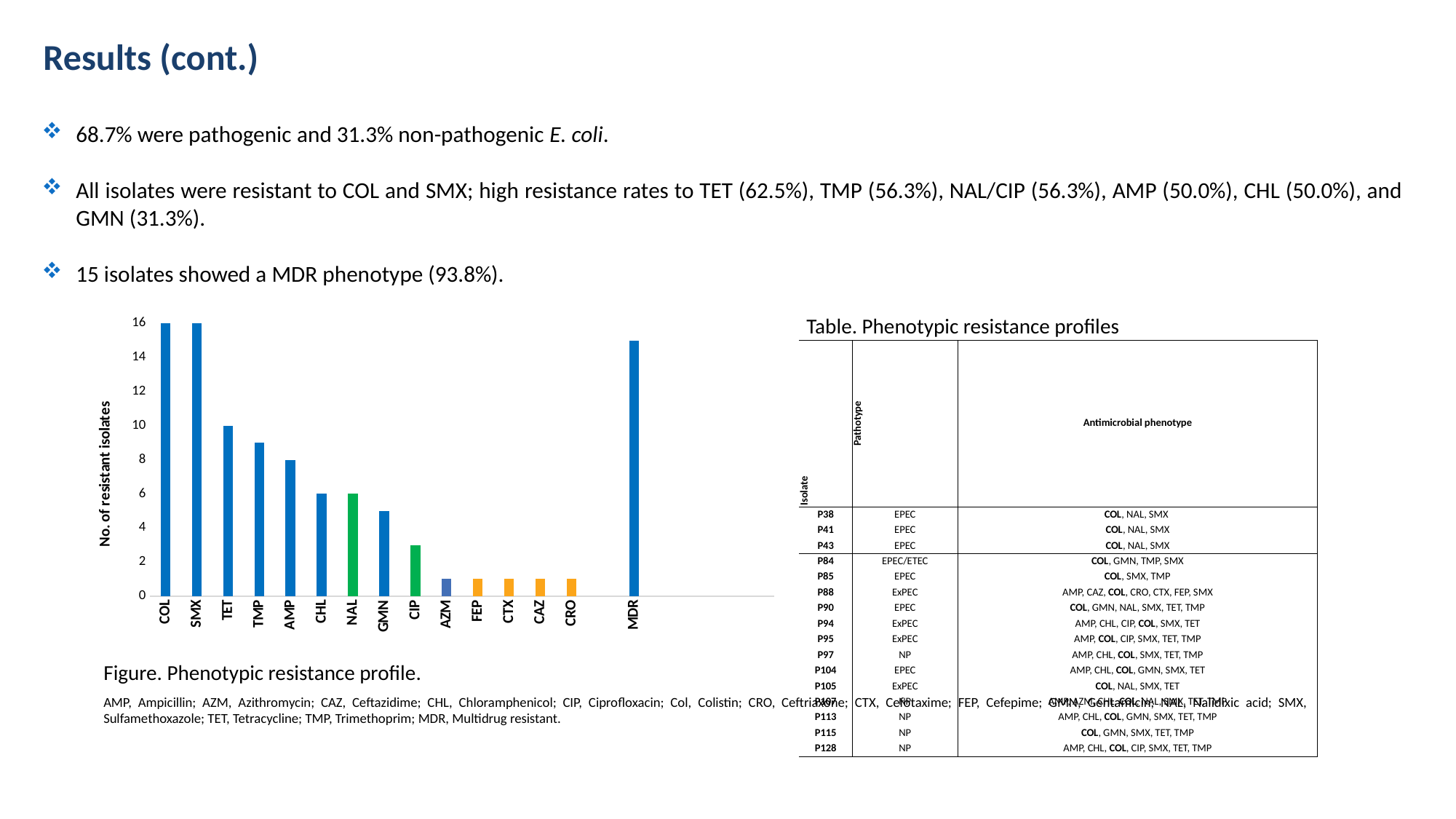
What is the difference between the number of resistant isolates for SMX and for TET in the bar chart? 6 How many categories are plotted along the x axis of the bar chart? 15 Is the value for MDR in the bar chart greater or less than 14? greater What type of chart is shown in the figure on the left of the slide? bar chart What is the label of the y axis of the bar chart? No. of resistant isolates What is the number of resistant isolates for NAL in the bar chart? 6 Is the value for CIP in the bar chart greater or less than 4? less What is the number of resistant isolates for AMP in the bar chart? 8 Do the bar values generally rise or fall moving from COL to CRO along the x axis? fall What is the number of resistant isolates for COL in the bar chart? 16 What is the number of resistant isolates for TET in the bar chart? 10 Which has more resistant isolates in the bar chart, TET or AMP? TET